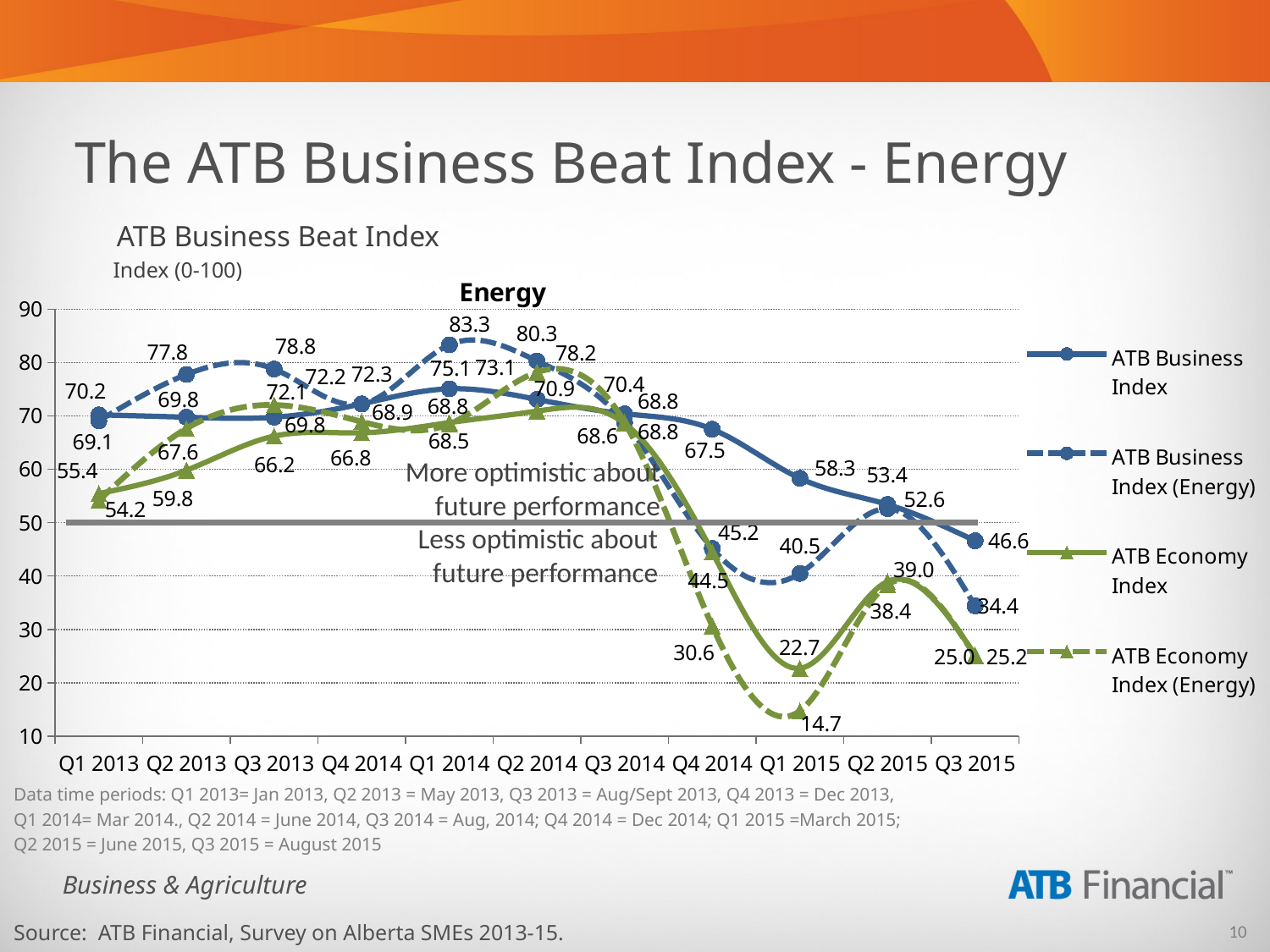
Does the ATB Business Index rise or fall from Q3 2014 to Q3 2015? fall What kind of chart is shown on the slide? line chart Is the value of the ATB Economy Index (Energy) in Q1 2015 greater or less than 20? less In which quarter does the ATB Economy Index (Energy) reach its lowest value? Q1 2015 What is the difference between the ATB Business Index (58.3) and the ATB Business Index (Energy) (40.5) in Q1 2015? 17.8 How many quarters are shown along the x axis of the chart? 11 How many series does the chart legend list? 4 What is the value of the ATB Business Index in Q3 2015? 46.6 In Q4 2014, which is larger: the ATB Business Index or the ATB Business Index (Energy)? ATB Business Index What is the value of the ATB Economy Index (Energy) in Q1 2015? 14.7 What is the value of the ATB Business Index (Energy) in Q1 2015? 40.5 In which quarter does the ATB Business Index (Energy) reach its highest value? Q1 2014